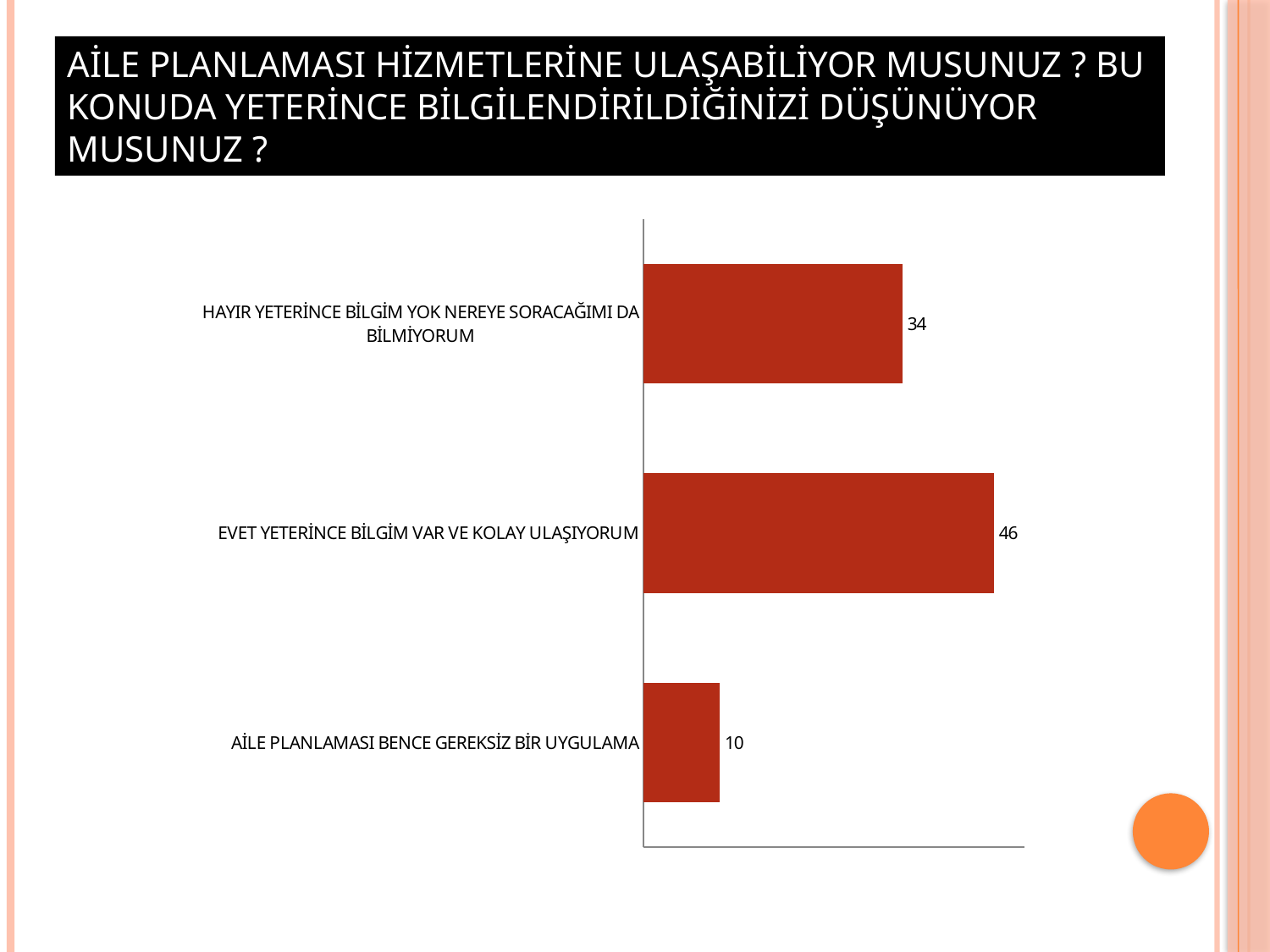
What is the value for "AİLE PLANLAMASI BENCE GEREKSİZ BİR UYGULAMA"? 10 Which is larger: the value for "HAYIR YETERİNCE BİLGİM YOK NEREYE SORACAĞIMI DA BİLMİYORUM" or for "AİLE PLANLAMASI BENCE GEREKSİZ BİR UYGULAMA"? HAYIR YETERİNCE BİLGİM YOK NEREYE SORACAĞIMI DA BİLMİYORUM Which category has the highest value? EVET YETERİNCE BİLGİM VAR VE KOLAY ULAŞIYORUM What is the difference between the values for "EVET YETERİNCE BİLGİM VAR VE KOLAY ULAŞIYORUM" and "HAYIR YETERİNCE BİLGİM YOK NEREYE SORACAĞIMI DA BİLMİYORUM"? 12 What colour are the bars in the chart? Red What is the total of all three values shown in the chart? 90 What is the value for "EVET YETERİNCE BİLGİM VAR VE KOLAY ULAŞIYORUM"? 46 What kind of chart is shown on the slide? Bar chart Which category has the lowest value? AİLE PLANLAMASI BENCE GEREKSİZ BİR UYGULAMA What is the difference between the values for "HAYIR YETERİNCE BİLGİM YOK NEREYE SORACAĞIMI DA BİLMİYORUM" and "AİLE PLANLAMASI BENCE GEREKSİZ BİR UYGULAMA"? 24 How many categories are shown in the chart? 3 What is the value for "HAYIR YETERİNCE BİLGİM YOK NEREYE SORACAĞIMI DA BİLMİYORUM"? 34